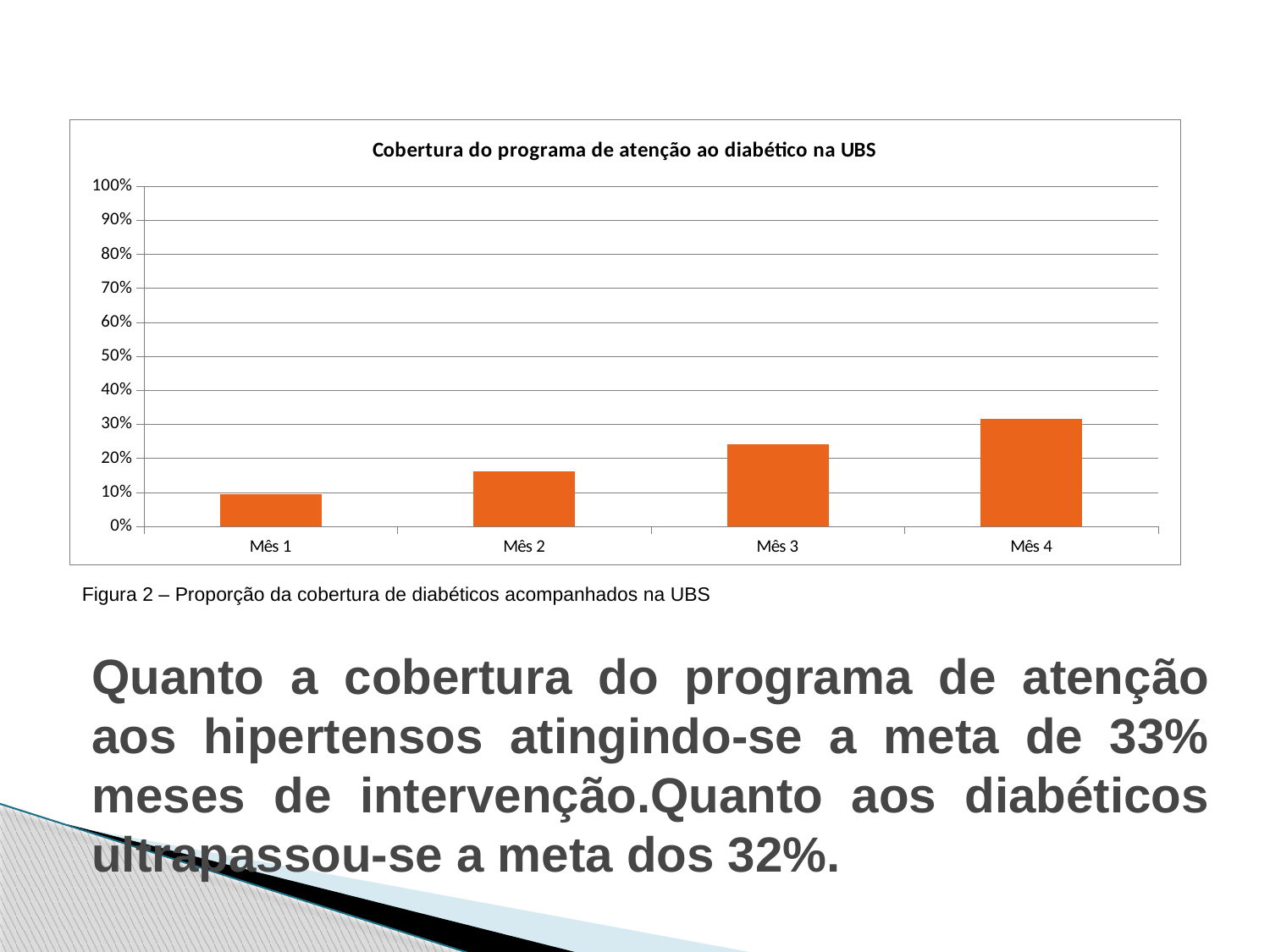
How many categories (months) are plotted on the x axis? 4 Is the value for Mês 2 greater or less than 20%? less Is the value for Mês 3 greater or less than 20%? greater Which is larger, the value for Mês 3 or the value for Mês 2? Mês 3 Which month has the highest coverage value? Mês 4 Is the value for Mês 4 greater or less than 40%? less What type of chart is shown on the slide? bar chart What is the title of the chart? Cobertura do programa de atenção ao diabético na UBS Do the values rise or fall from Mês 1 to Mês 4? rise Which is larger, the value for Mês 1 or the value for Mês 4? Mês 4 Which month has the lowest coverage value? Mês 1